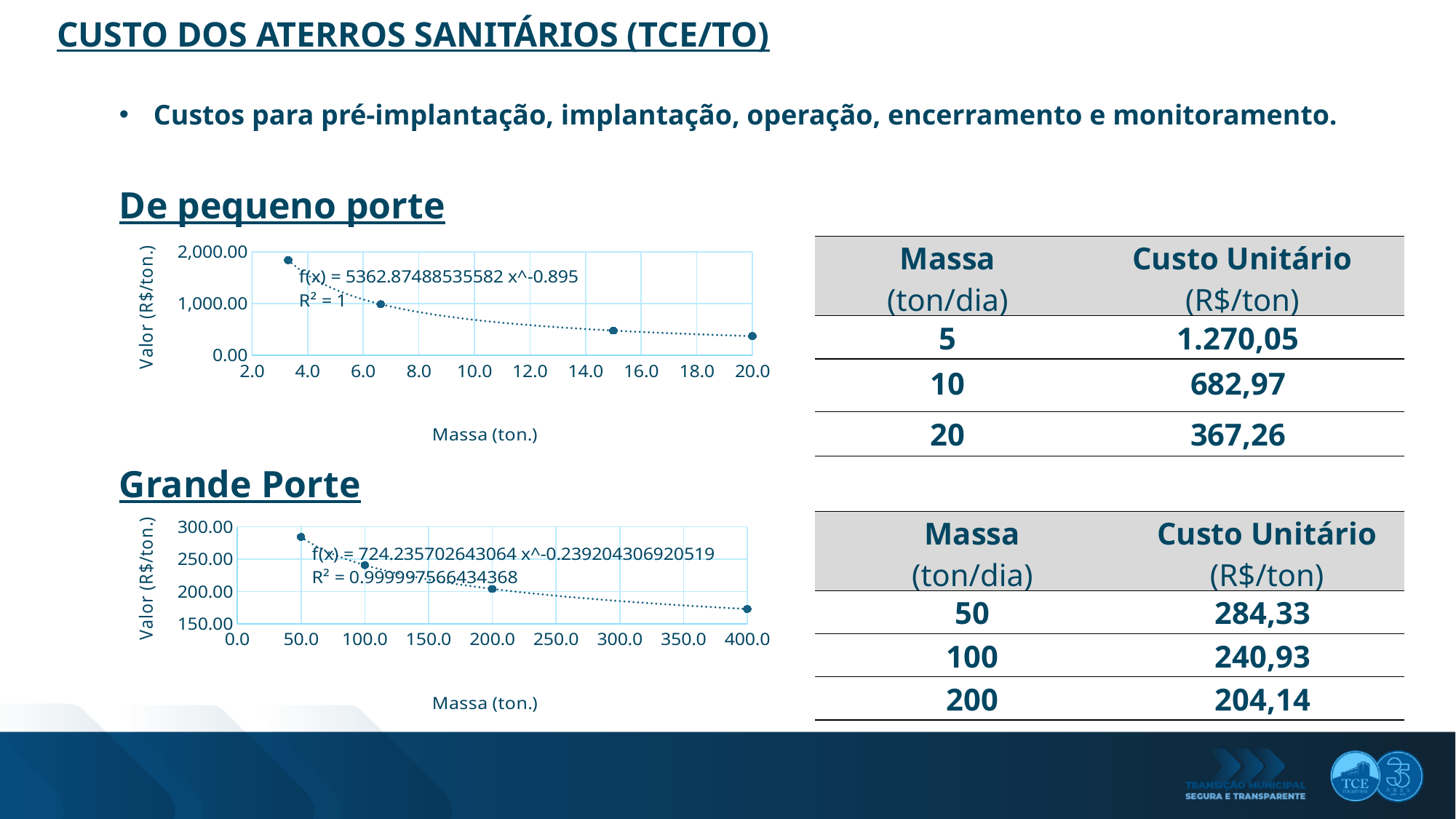
In the 'Grande Porte' chart, do the values rise or fall as Massa increases? fall In the 'De pequeno porte' chart, how many data points are plotted? 4 In the 'Grande Porte' chart, at which Massa value is the plotted value highest? 50.0 In the 'De pequeno porte' chart, is the value of the leftmost point greater or less than 1,000.00? greater What is the y-axis title of the 'De pequeno porte' chart? Valor (R$/ton.) What is the x-axis title of the 'Grande Porte' chart? Massa (ton.) In the 'De pequeno porte' chart, is the value at Massa 20.0 greater or less than 1,000.00? less What kind of chart is the 'De pequeno porte' chart? scatter chart In the 'Grande Porte' chart, how many data points are plotted? 4 What kind of chart is the 'Grande Porte' chart? scatter chart In the 'De pequeno porte' chart, do the values rise or fall as Massa increases? fall In the 'Grande Porte' chart, is the value at Massa 400.0 greater or less than 200.00? less